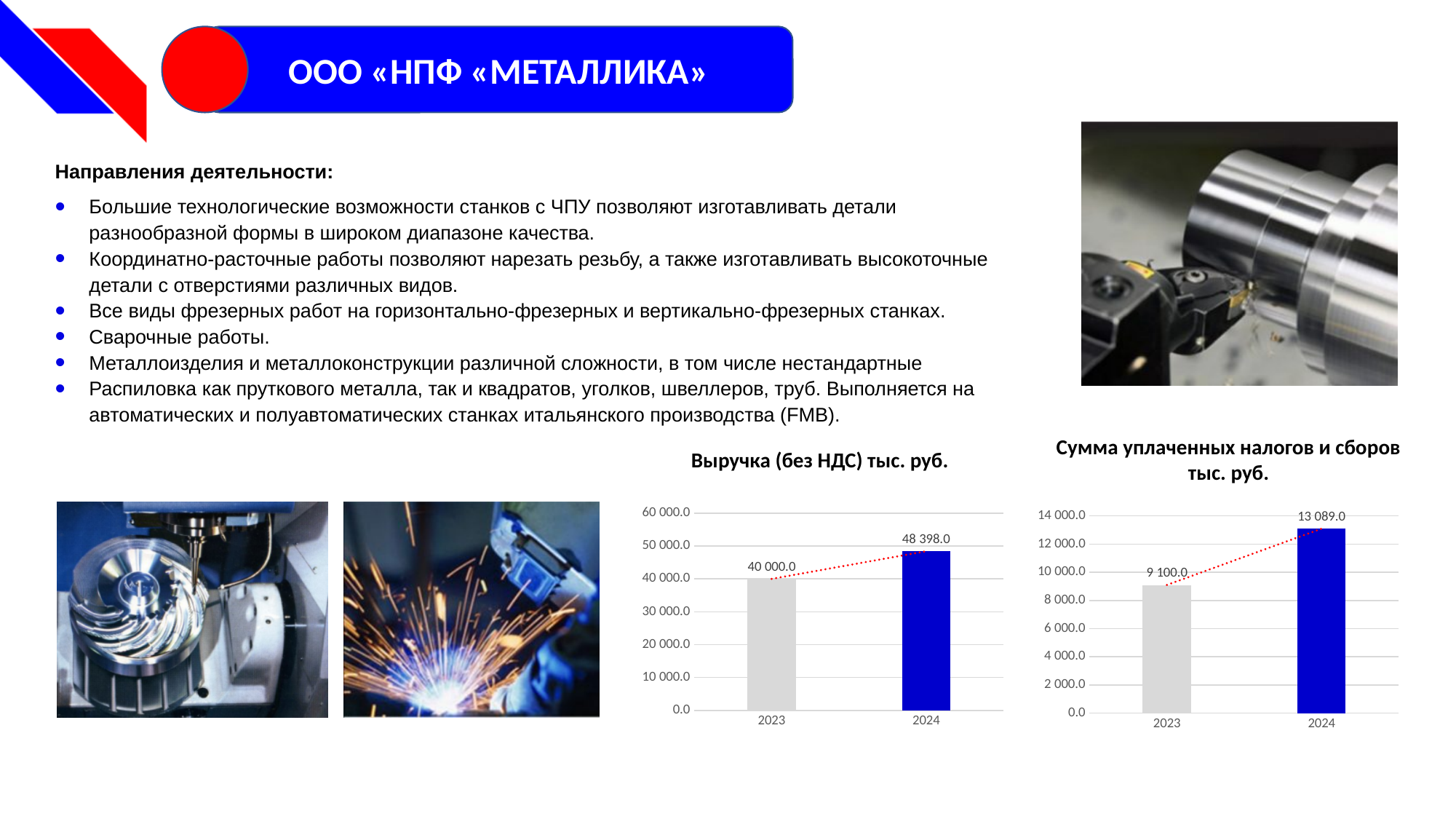
In the chart titled "Выручка (без НДС) тыс. руб.", what is the difference between the 2024 and 2023 values? 8 398.0 In the chart titled "Выручка (без НДС) тыс. руб.", what is the value for 2023? 40 000.0 In the chart titled "Сумма уплаченных налогов и сборов тыс. руб.", what is the value for 2023? 9 100.0 In the chart titled "Сумма уплаченных налогов и сборов тыс. руб.", what is the value for 2024? 13 089.0 In the chart titled "Выручка (без НДС) тыс. руб.", what is the value for 2024? 48 398.0 In the chart titled "Выручка (без НДС) тыс. руб.", do the values rise or fall from 2023 to 2024? rise In the chart titled "Сумма уплаченных налогов и сборов тыс. руб.", which year has the lower value? 2023 In the chart titled "Сумма уплаченных налогов и сборов тыс. руб.", what is the difference between the 2024 and 2023 values? 3 989.0 In the chart titled "Сумма уплаченных налогов и сборов тыс. руб.", is the value for 2024 greater or less than 12 000.0? greater What kind of chart is the chart titled "Сумма уплаченных налогов и сборов тыс. руб."? bar chart How many years are shown in the chart titled "Выручка (без НДС) тыс. руб."? 2 In the chart titled "Выручка (без НДС) тыс. руб.", which year has the higher value? 2024